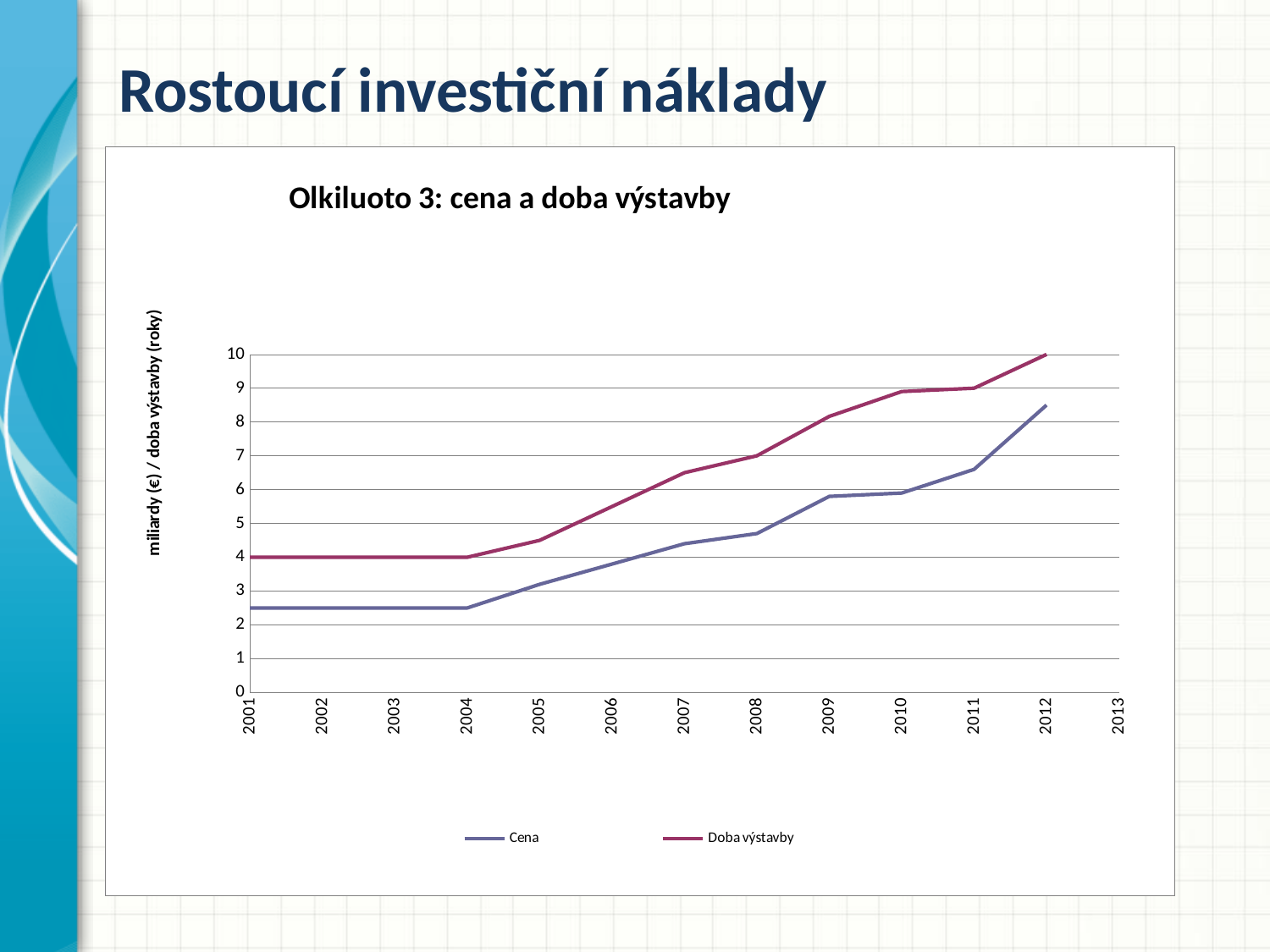
What is the value of Doba výstavby in 2011? 9 Is the value for Cena in 2012 greater or less than 8? greater What is the value of Doba výstavby in 2001? 4 What is the value of Doba výstavby in 2008? 7 Is the value for Cena in 2001 greater or less than 3? less What is the title of the chart? Olkiluoto 3: cena a doba výstavby What type of chart is shown on the slide? line chart How many series does the legend list? 2 Does the Cena series rise or fall from 2004 to 2012? rise Is the value for Doba výstavby in 2007 greater or less than 6? greater What is the value of Doba výstavby in 2012? 10 In 2012, which series has the higher value, Cena or Doba výstavby? Doba výstavby